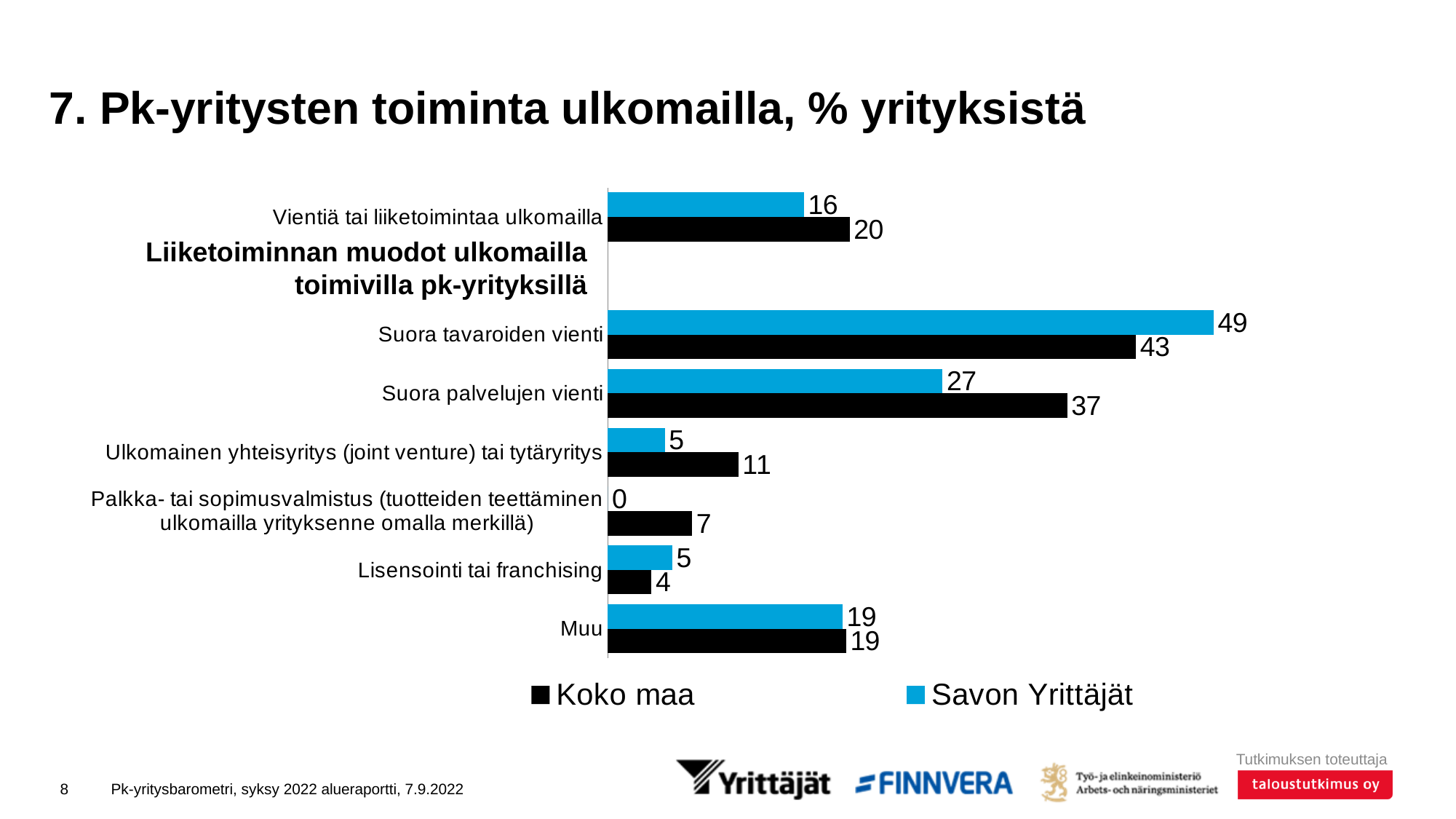
Which category has the highest value for Koko maa? Suora tavaroiden vienti What is the value for Savon Yrittäjät for Palkka- tai sopimusvalmistus (tuotteiden teettäminen ulkomailla yrityksenne omalla merkillä)? 0 What is the value for Koko maa for Vientiä tai liiketoimintaa ulkomailla? 20 For Ulkomainen yhteisyritys (joint venture) tai tytäryritys, which series has the larger value, Koko maa or Savon Yrittäjät? Koko maa What kind of chart is shown on the slide? Bar chart What is the value for Savon Yrittäjät for Suora tavaroiden vienti? 49 How many series does the legend list? 2 Which category has the lowest value for Koko maa? Lisensointi tai franchising What is the value for Koko maa for Suora palvelujen vienti? 37 How many categories are shown in the chart? 7 What is the difference between the Koko maa and Savon Yrittäjät values for Suora palvelujen vienti? 10 Which colour represents Savon Yrittäjät in the chart? Blue